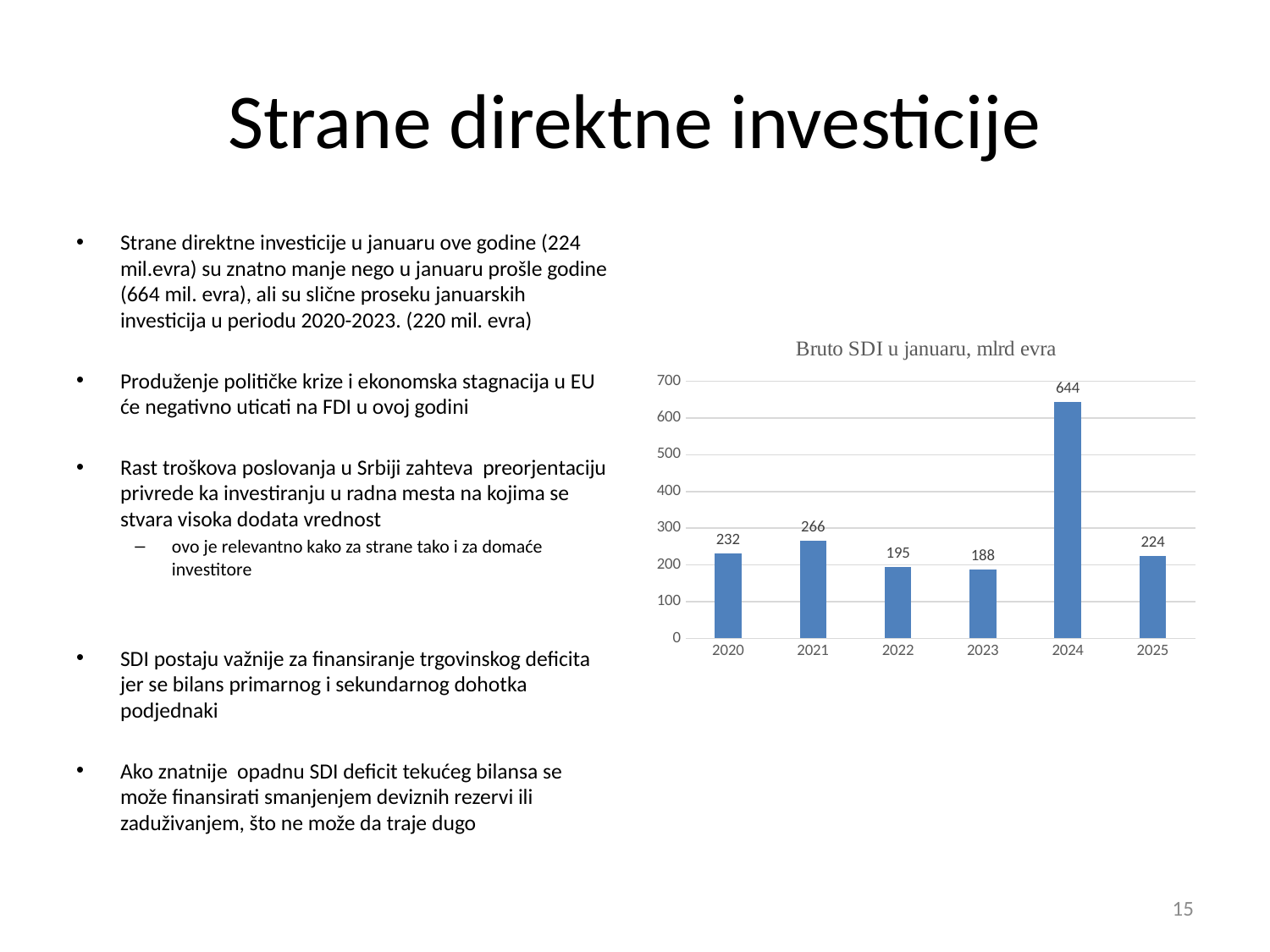
What is the title of the chart? Bruto SDI u januaru, mlrd evra What is the difference between the values for 2024 and 2025? 420 What is the value for 2025 in the chart? 224 What is the value for 2020 in the chart? 232 Is the value for 2024 greater or less than 600? greater Which year has the highest value in the chart? 2024 What is the difference between the values for 2021 and 2022? 71 What is the value for 2024 in the chart? 644 Which is larger, the value for 2020 or the value for 2021? 2021 Which year has the lowest value in the chart? 2023 How many years are shown on the x axis of the chart? 6 What kind of chart is shown on the slide? bar chart